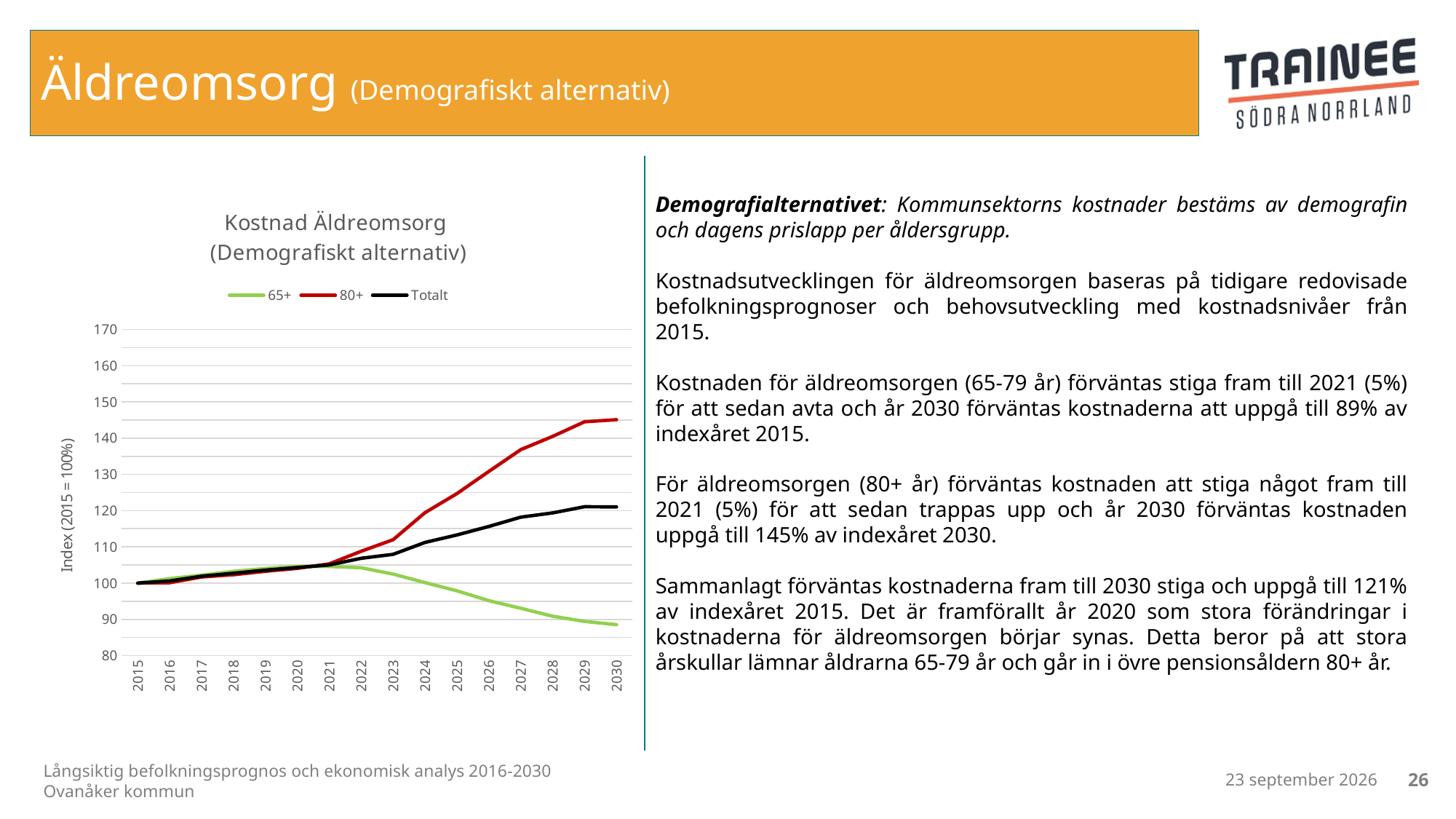
How many years are plotted along the x axis of the chart? 16 Which series has the highest value in 2030? 80+ Is the value for the Totalt series in 2030 greater or less than 110? greater Is the value for the 65+ series in 2030 greater or less than 90? less Is the value for the 80+ series in 2030 greater or less than 140? greater What kind of chart is shown on the slide? line chart Which series has the lowest value in 2030? 65+ How many series does the legend of the chart list? 3 Does the 65+ series rise or fall between 2022 and 2030? fall In 2030, which series is larger, 65+ or Totalt? Totalt What is the index value of the Totalt series in 2015? 100 What colour is the line for the 80+ series? red